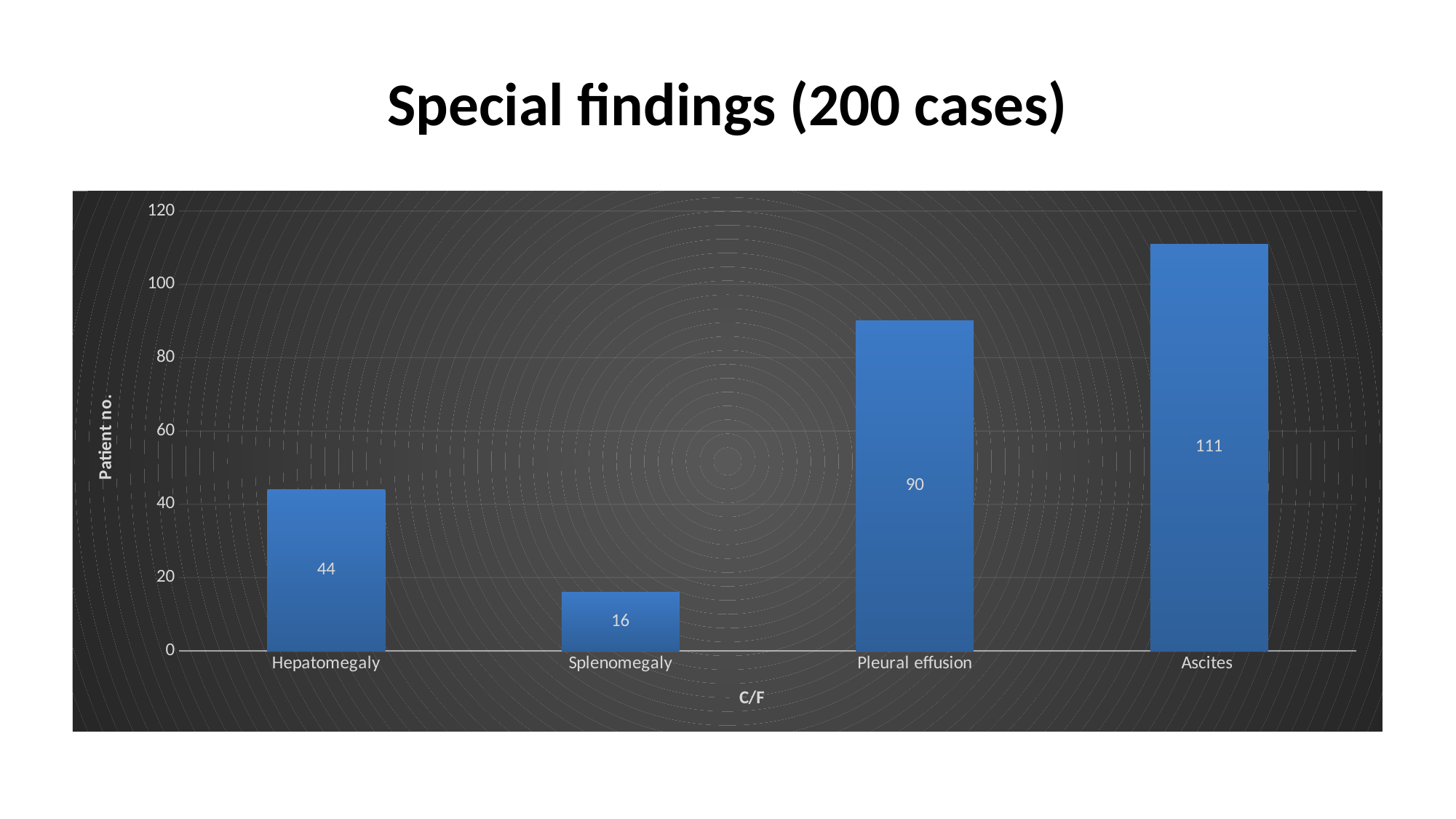
What is the difference in patient number between Hepatomegaly and Splenomegaly? 28 What is the patient number for Ascites? 111 What is the difference in patient number between Ascites and Pleural effusion? 21 Which finding has the lowest patient number? Splenomegaly How many findings (categories) are shown on the chart? 4 What kind of chart is shown on the slide? Bar chart What is the patient number for Hepatomegaly? 44 What is the patient number for Pleural effusion? 90 Which finding has the highest patient number? Ascites What is the title of the chart? Special findings (200 cases) Which has a larger patient number, Hepatomegaly or Pleural effusion? Pleural effusion What is the patient number for Splenomegaly? 16